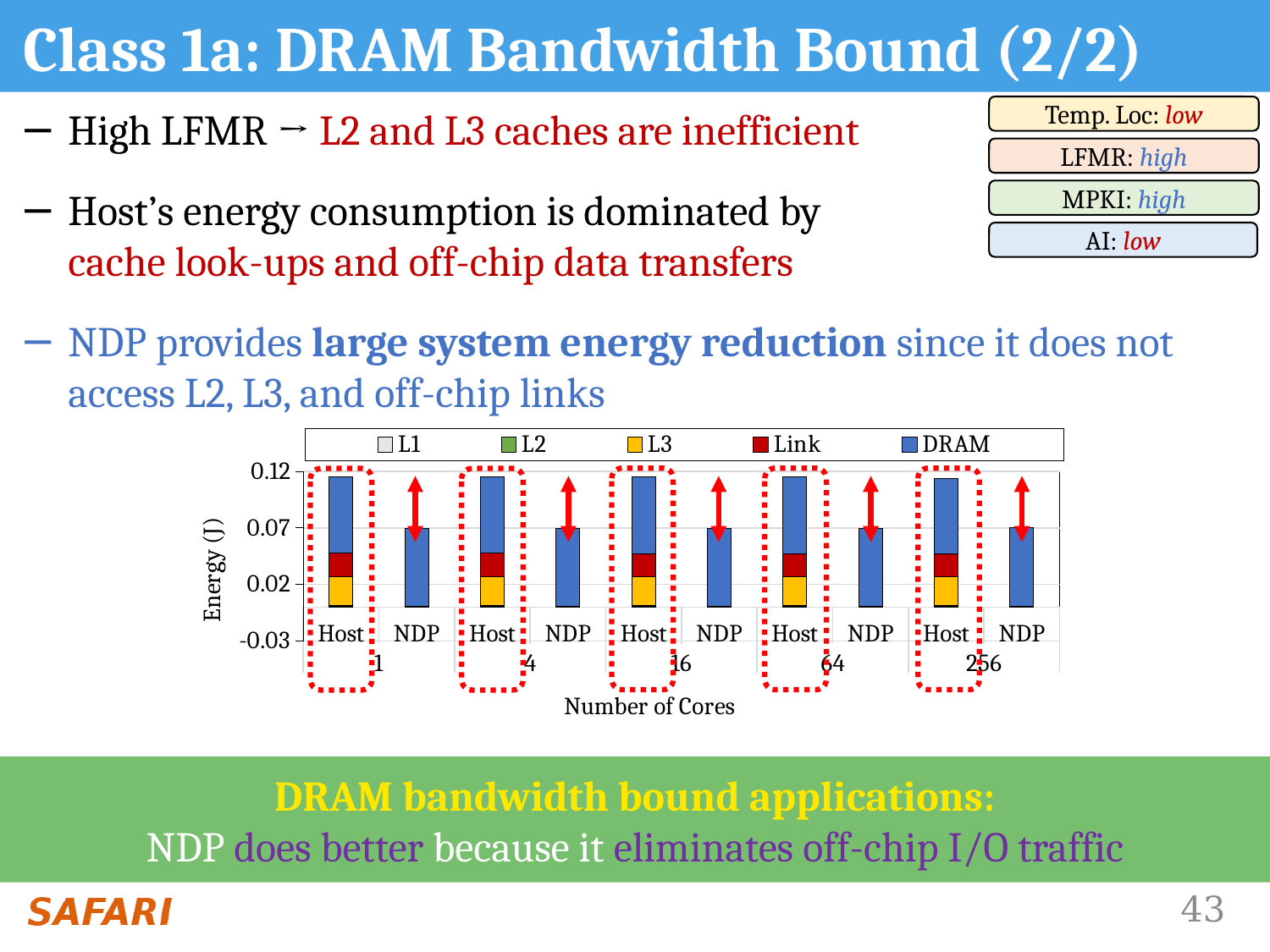
What kind of chart is shown on the slide? bar chart Is the total energy of the Host bar at 256 cores greater or less than 0.02? greater How many bars are plotted in the chart in total? 10 How many different numbers of cores are shown on the x axis of the chart? 5 Which single series makes up the NDP bars in the chart? DRAM Is the total energy of the NDP bar at 64 cores greater or less than 0.12? less Is the total energy of the Host bar at 16 cores greater or less than 0.07? greater Do the Host bars rise, fall, or stay roughly constant as the number of cores increases from 1 to 256? stay roughly constant How many series does the chart's legend list? 5 What are the series listed in the chart's legend? L1, L2, L3, Link, DRAM At 4 cores, which has the higher total energy, Host or NDP? Host At 1 core, which bar is taller, Host or NDP? Host